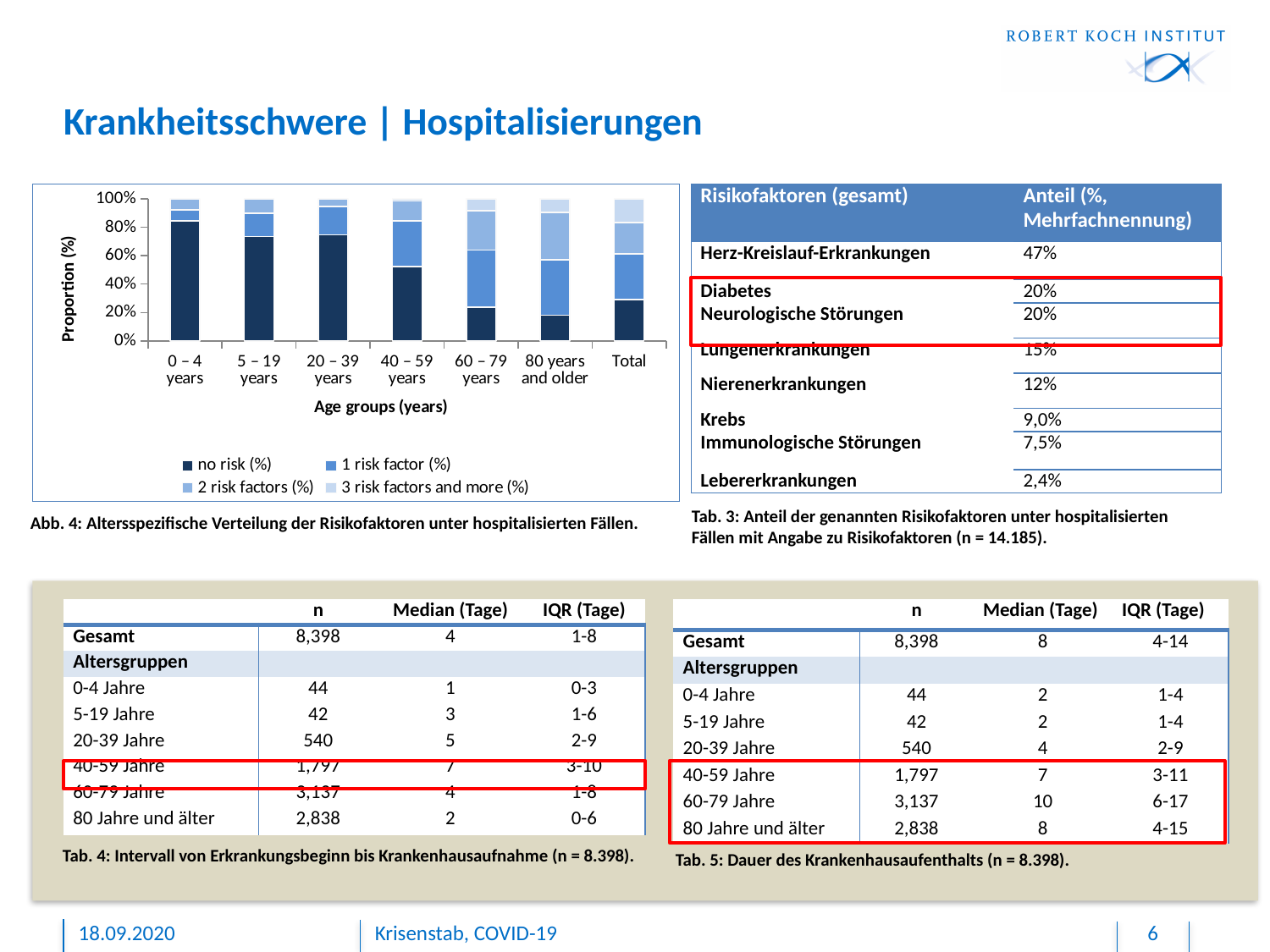
Which age group has the highest share of 'no risk (%)' in the bar chart? 0 – 4 years Is the 'no risk (%)' value for the 0 – 4 years group greater or less than 60%? greater What kind of chart is shown on the slide? Stacked bar chart Which has a larger 'no risk (%)' share: the 0 – 4 years group or the 60 – 79 years group? 0 – 4 years What is the label of the x axis of the bar chart? Age groups (years) How many series does the legend of the bar chart list? 4 Which age group has the lowest share of 'no risk (%)' in the bar chart? 80 years and older Is the 'no risk (%)' value for the 40 – 59 years group greater or less than 40%? greater Does the 'no risk (%)' share generally rise or fall as the age groups increase from 0 – 4 years to 80 years and older? fall Is the 'no risk (%)' value for the 80 years and older group greater or less than 40%? less How many age-group categories are plotted on the x axis of the bar chart? 7 What is the label of the y axis of the bar chart? Proportion (%)